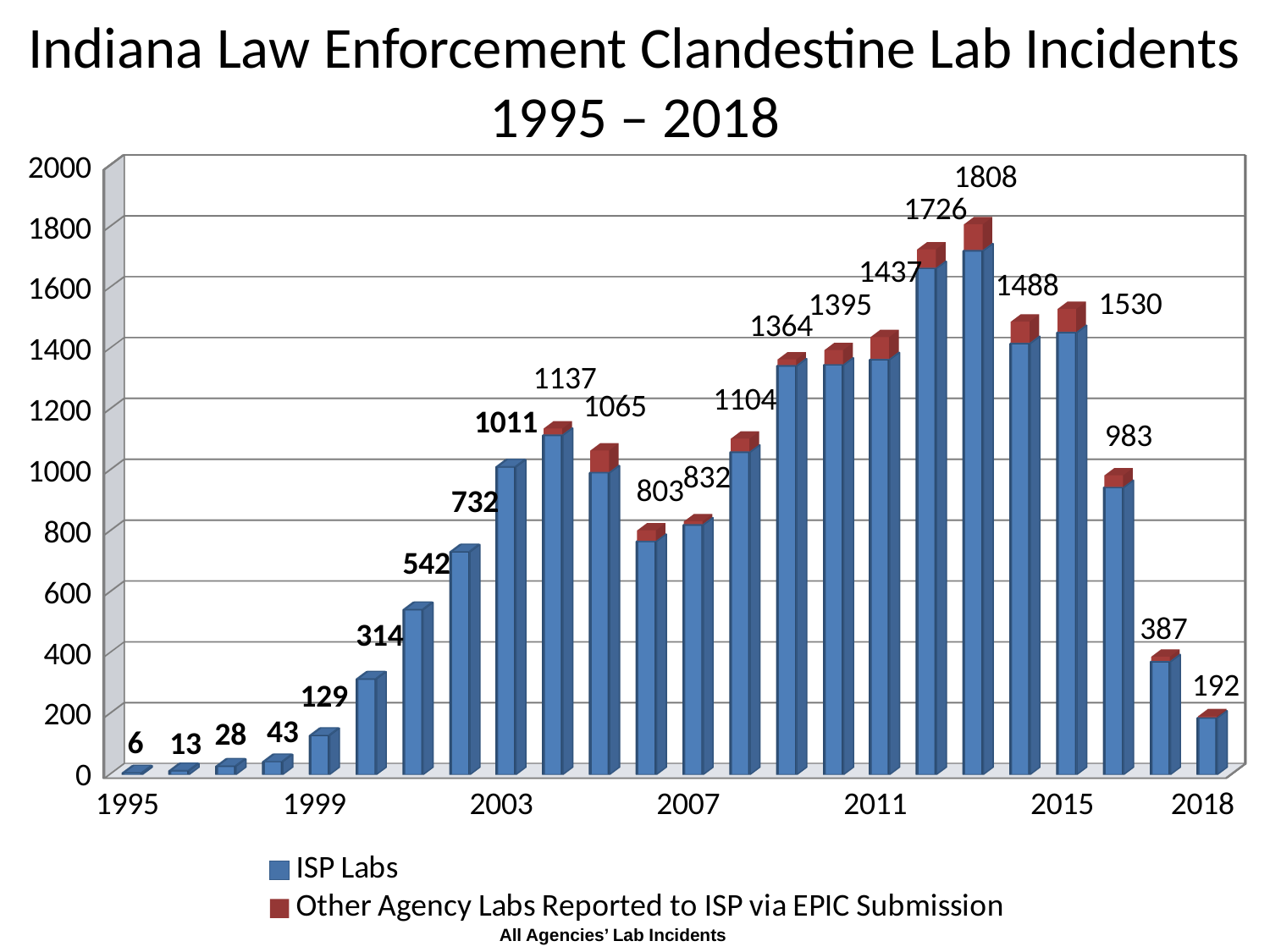
Which year has a larger total, 2007 or 2011? 2011 What is the highest total value labelled on the chart? 1808 What is the difference between the totals for 2015 and 2018? 1338 How many series does the legend list? 2 What is the total number of clandestine lab incidents shown for 2018? 192 What is the total number of clandestine lab incidents shown for 1999? 129 Which series is shown in red in the legend? Other Agency Labs Reported to ISP via EPIC Submission What kind of chart is shown on the slide? Stacked bar chart What is the total number of clandestine lab incidents shown for 2003? 1011 What is the total number of clandestine lab incidents shown for 1995? 6 Is the total for 2015 greater or less than 1400? greater Which year has the lowest total number of lab incidents? 1995